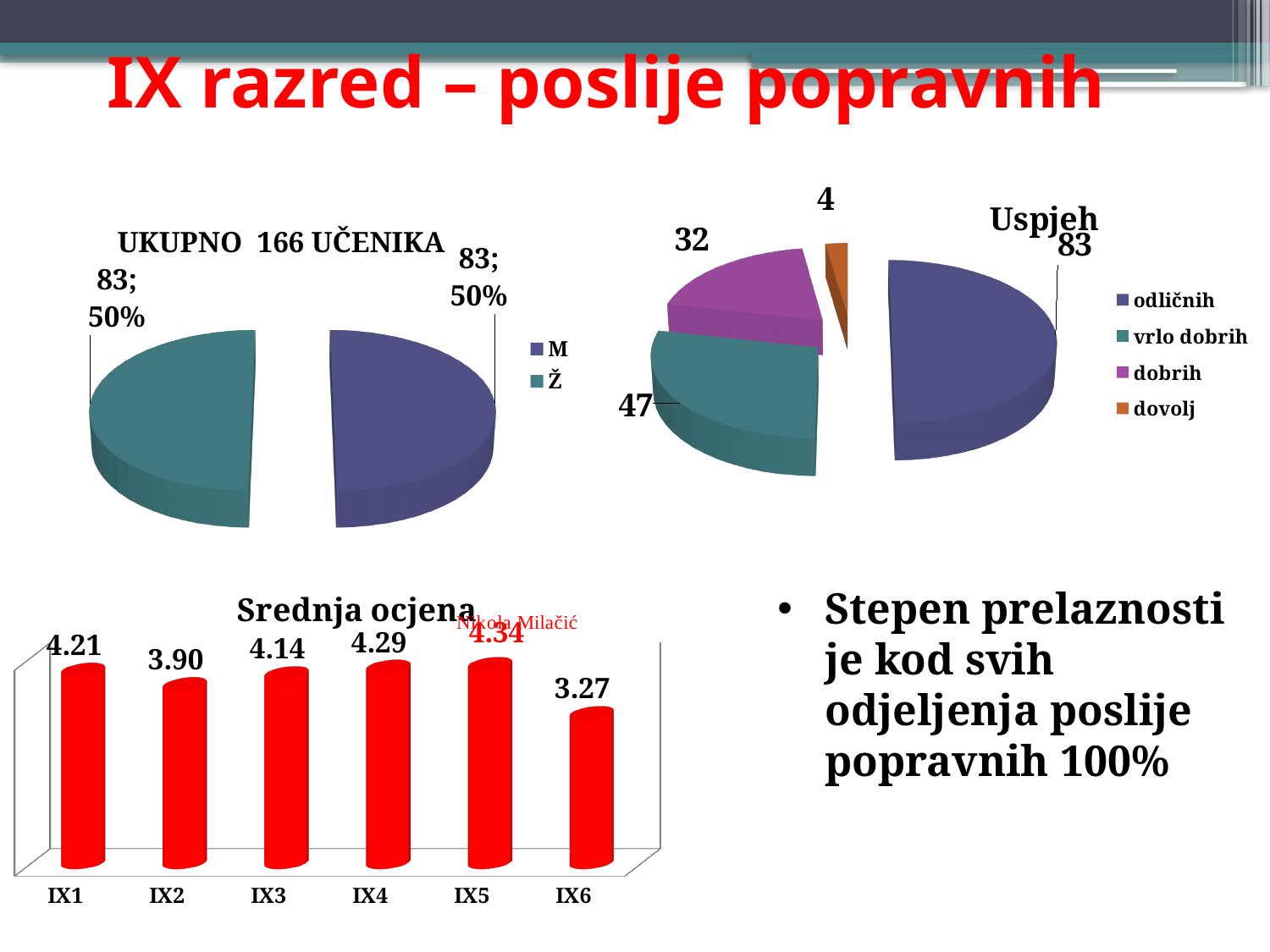
In the 'Srednja ocjena' chart, what is the value for IX4? 4.29 In the 'Uspjeh' pie chart, what is the difference between 'odličnih' and 'dobrih'? 51 In the 'Srednja ocjena' chart, which is larger, the value for IX2 or the value for IX3? IX3 What kind of chart is the 'Srednja ocjena' chart? bar chart In the 'Uspjeh' pie chart, what is the value for 'vrlo dobrih'? 47 In the 'Srednja ocjena' chart, which class has the highest average grade? IX5 In the 'Uspjeh' pie chart, which category has the smallest slice? dovolj How many classes are shown in the 'Srednja ocjena' chart? 6 In the 'Srednja ocjena' chart, what is the difference between the values for IX1 and IX6? 0.94 In the 'Srednja ocjena' chart, which class has the lowest average grade? IX6 How many series does the legend of the 'Uspjeh' pie chart list? 4 In the 'UKUPNO 166 UČENIKA' pie chart, what share does 'M' have? 50%